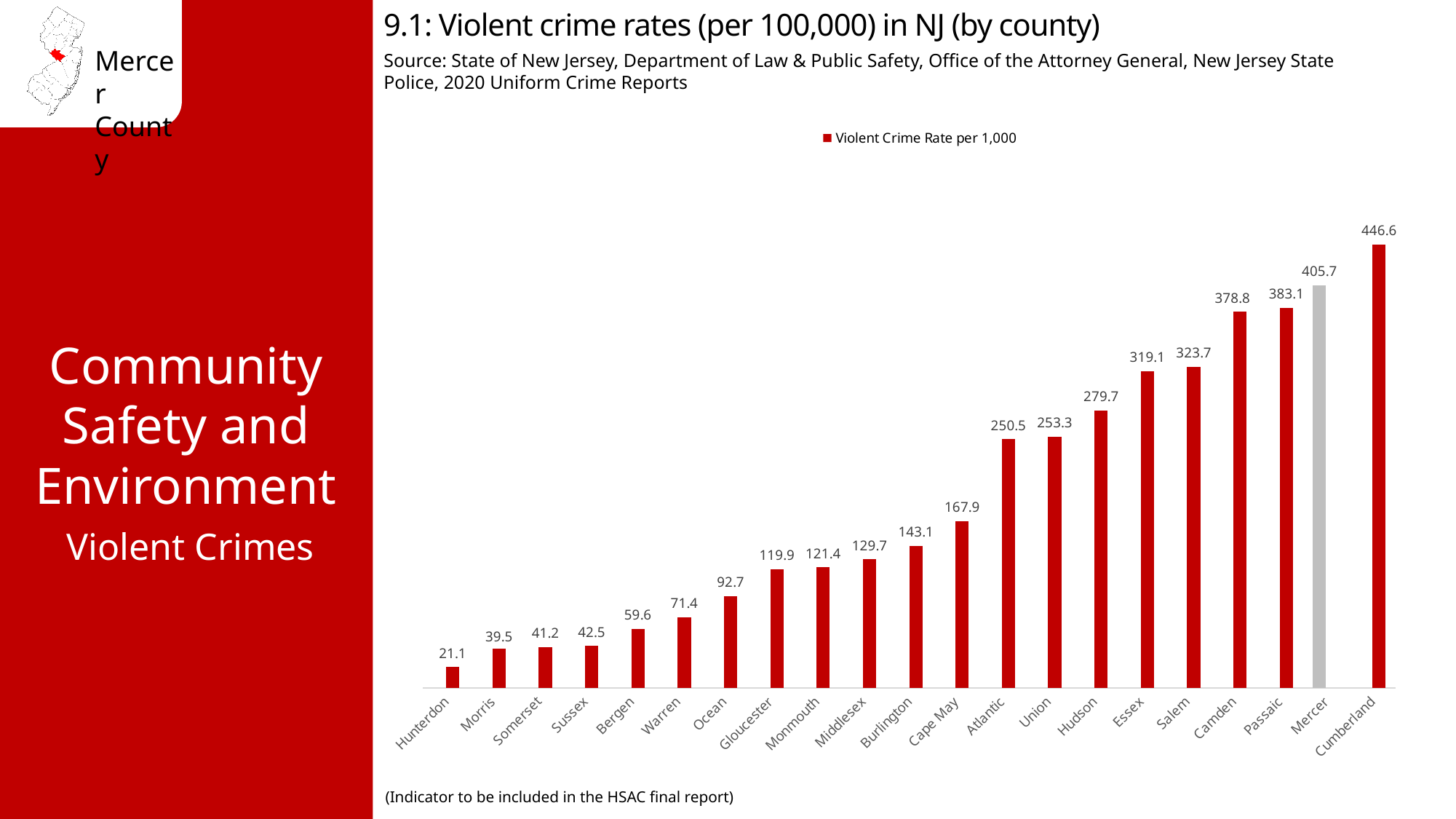
What is the violent crime rate for Cape May County? 167.9 What is the difference between the violent crime rates of Mercer and Hunterdon counties? 384.6 Which county has the highest violent crime rate? Cumberland How many counties are shown on the chart? 21 What is the violent crime rate for Hudson County? 279.7 Which county has the lowest violent crime rate? Hunterdon Which county's bar is shown in grey rather than red? Mercer How many series does the legend list? 1 What is the violent crime rate for Mercer County? 405.7 Which county has a higher violent crime rate, Camden or Essex? Camden What kind of chart is shown on the slide? Bar chart What is the difference between the violent crime rates of Cumberland and Mercer counties? 40.9